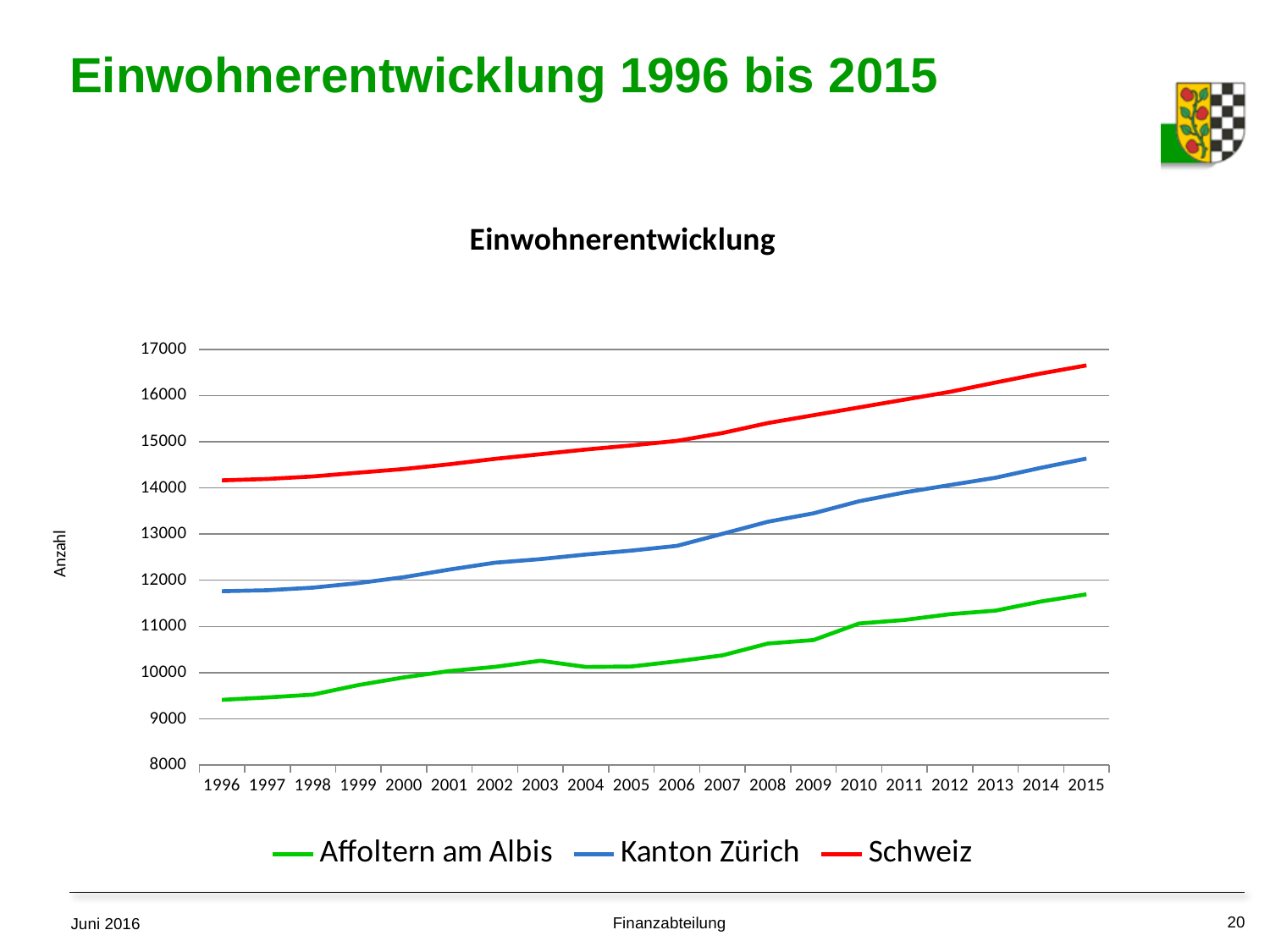
How many series does the legend list? 3 How many years are plotted along the x axis? 20 Is the value for Affoltern am Albis in 1996 greater or less than 10000? less What is the title of the chart? Einwohnerentwicklung Do the values for Affoltern am Albis rise or fall from 1996 to 2015? rise Is the value for Schweiz in 2015 greater or less than 16000? greater Is the value for Kanton Zürich in 1996 greater or less than 12000? less Which series has the lowest values across the whole period? Affoltern am Albis Which series has the highest values across the whole period? Schweiz In 2015, which is larger: the value for Schweiz or the value for Kanton Zürich? Schweiz What type of chart is shown on the slide? line chart